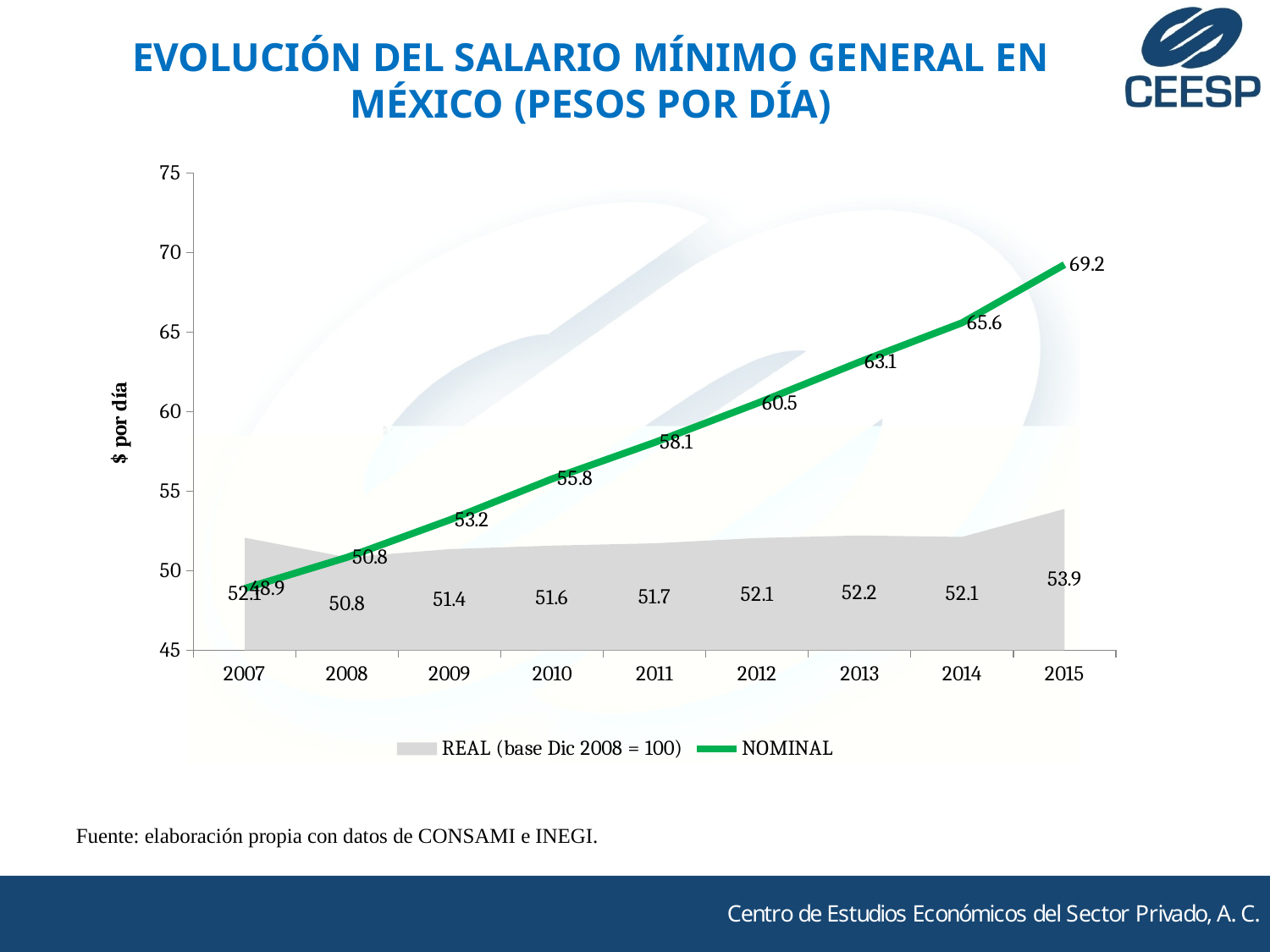
What is the difference between the NOMINAL values for 2015 and 2007? 20.3 How many years are shown on the x axis? 9 What is the NOMINAL value for 2010? 55.8 In which year is the NOMINAL value highest? 2015 What is the NOMINAL value for 2015? 69.2 How many series does the legend list? 2 In which year is the REAL (base Dic 2008 = 100) value lowest? 2008 Does the NOMINAL series rise or fall from 2007 to 2015? rise Which is larger in 2007, the NOMINAL value or the REAL value? REAL Is the NOMINAL value for 2012 greater or less than 60? greater What is the REAL (base Dic 2008 = 100) value for 2008? 50.8 What is the REAL (base Dic 2008 = 100) value for 2013? 52.2